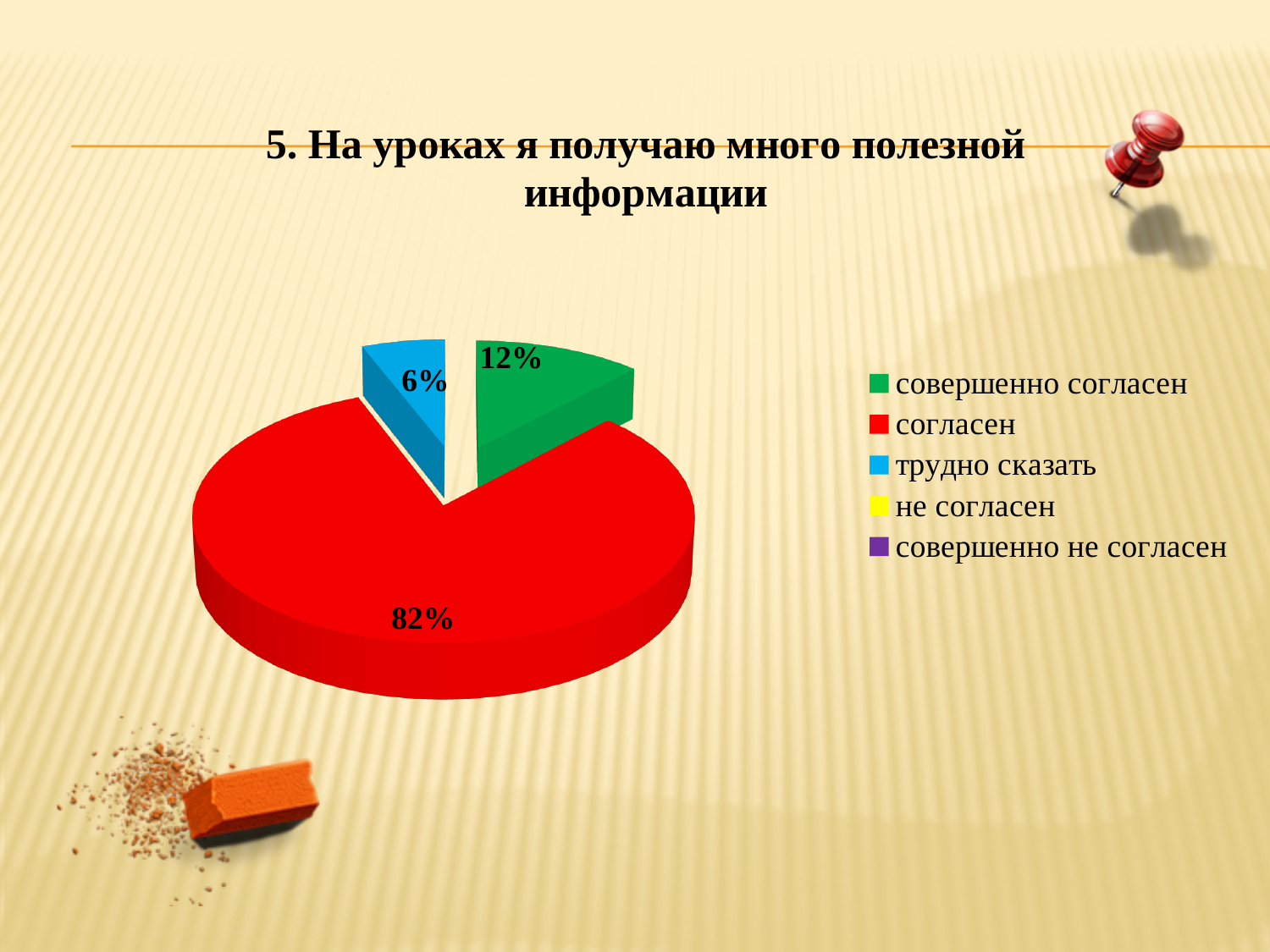
What kind of chart is shown on the slide? pie chart What colour is the slice for "согласен"? red What share of the pie does "совершенно согласен" take? 12% Which of the visible slices is the smallest? трудно сказать Which category has the largest slice of the pie? согласен Which is larger, the slice for "совершенно согласен" or the slice for "трудно сказать"? совершенно согласен What share of the pie does "согласен" take? 82% What is the title of the chart? 5. На уроках я получаю много полезной информации What is the difference between the shares for "совершенно согласен" and "трудно сказать"? 6% What is the difference between the shares for "согласен" and "совершенно согласен"? 70% What share of the pie does "трудно сказать" take? 6% How many entries does the legend list? 5